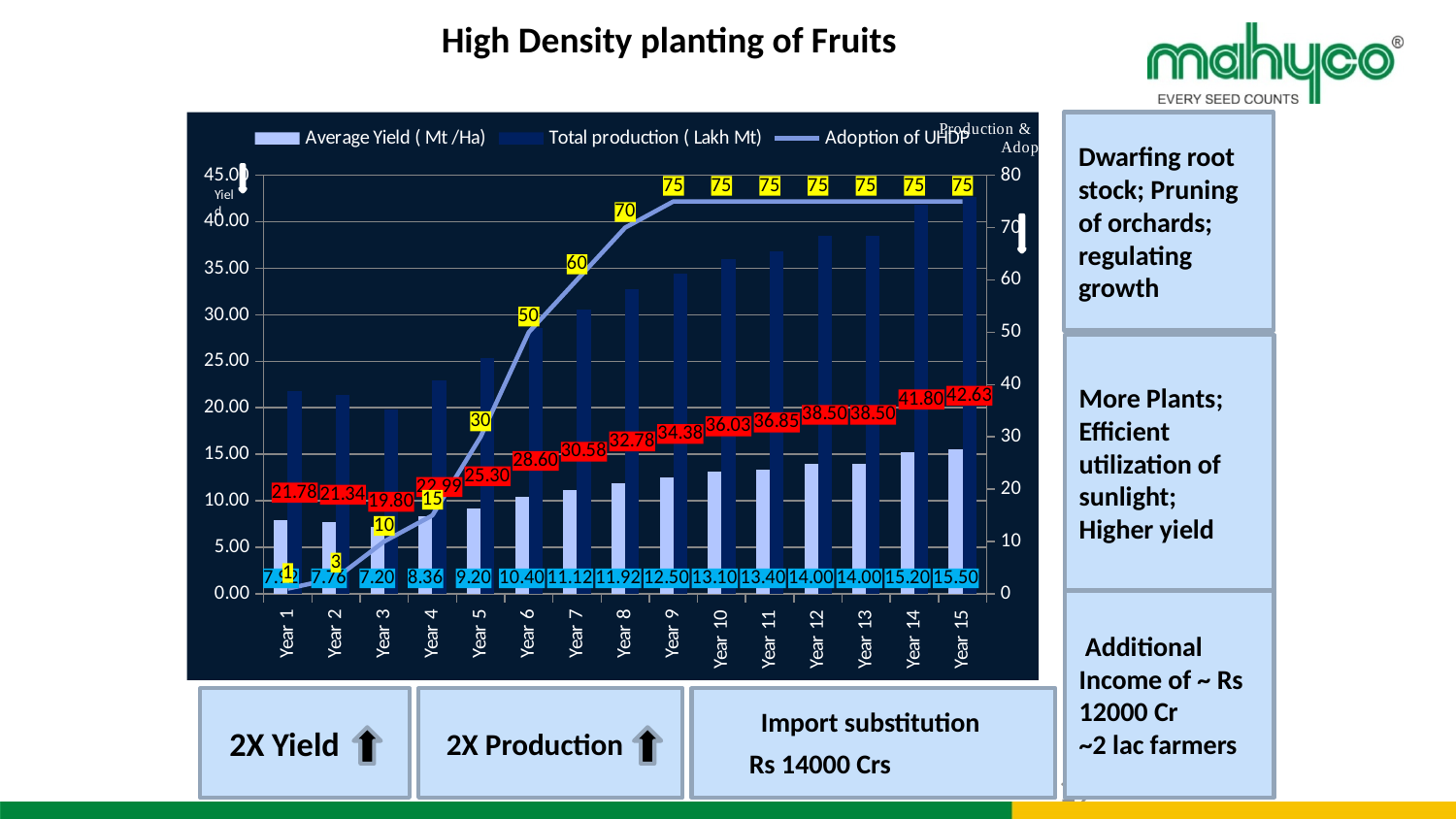
In which year is Average Yield the lowest? Year 3 What is the difference in Total production between Year 15 and Year 14? 0.83 Which year has a higher Average Yield, Year 9 or Year 14? Year 14 What is the Adoption of UHDP value in Year 6? 50 In which year is Total production the highest? Year 15 Is the Total production in Year 8 greater or less than 30? greater How many series does the chart legend list? 3 How many years are shown on the x axis of the chart? 15 What is the Average Yield (Mt/Ha) in Year 15? 15.50 Does the Adoption of UHDP line rise or fall from Year 1 to Year 8? rise What is the Total production (Lakh Mt) in Year 10? 36.03 What is the difference in Average Yield between Year 15 and Year 5? 6.30